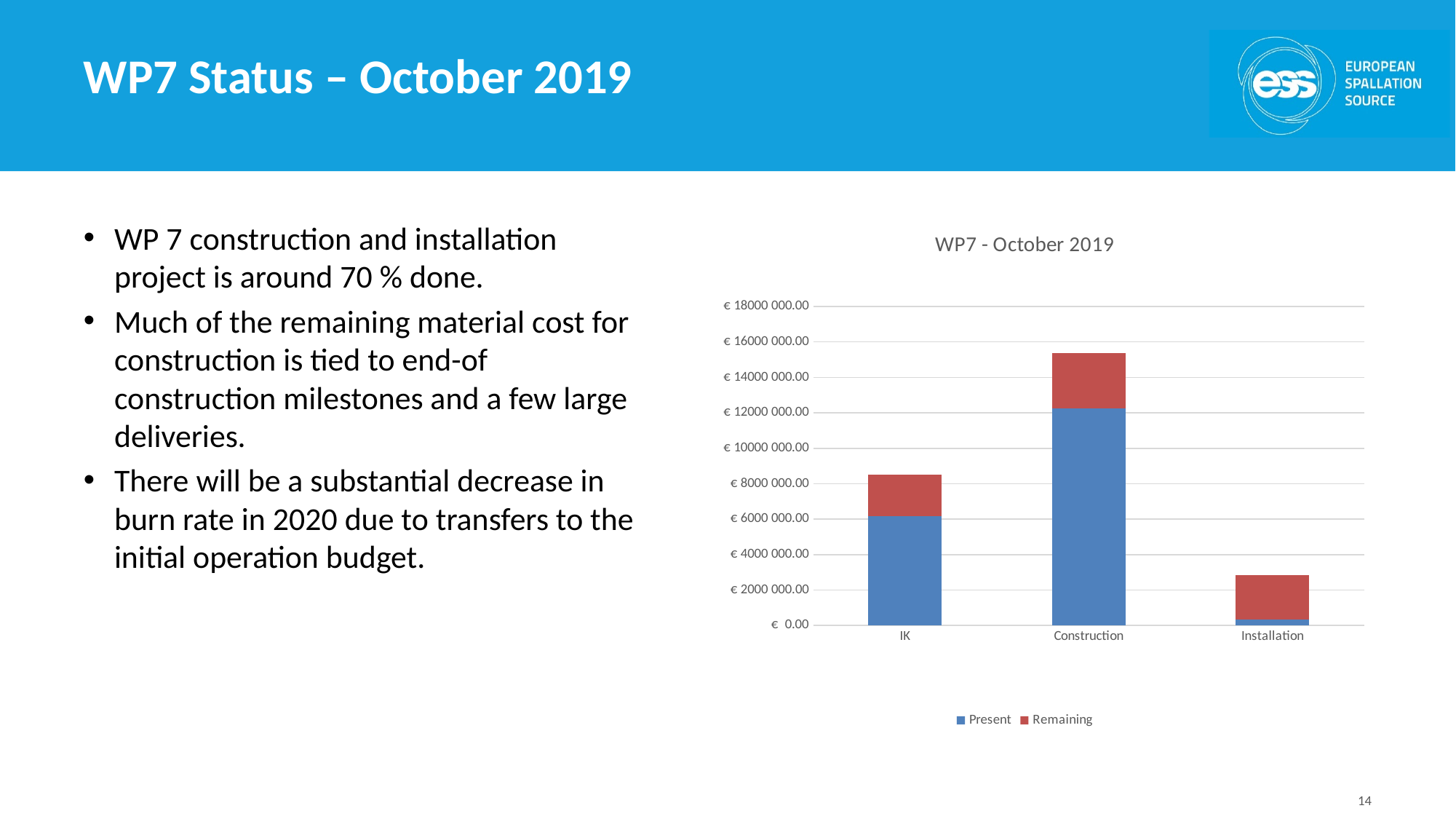
What is the title of the chart? WP7 - October 2019 Is the total bar for Installation greater or less than € 4000 000.00? less What type of chart is shown on the slide? Stacked bar chart Which has the larger total bar, IK or Installation? IK Which series is shown in red in the chart? Remaining How many categories are shown on the x axis of the chart? 3 How many series does the chart legend list? 2 Is the Present value for IK greater or less than € 4000 000.00? greater Which category has the lowest total bar in the chart? Installation Which has the larger Present value, IK or Construction? Construction Which category has the highest total bar in the chart? Construction Is the total bar for Construction greater or less than € 14000 000.00? greater